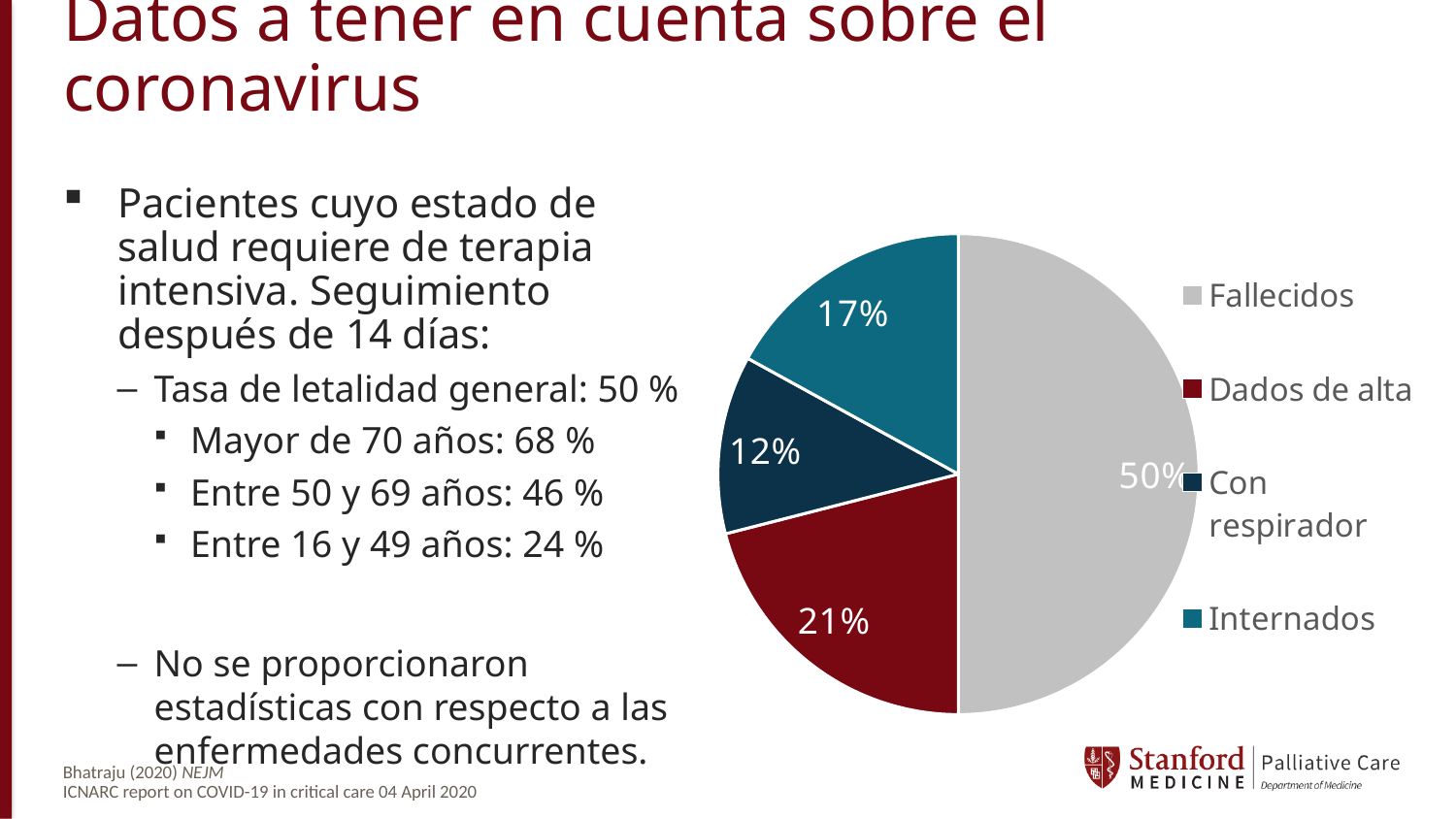
How many categories does the pie chart legend list? 4 Which category has the smallest slice of the pie chart? Con respirador What colour is the Fallecidos slice in the pie chart? grey What percentage of the pie chart is labelled Con respirador? 12% Which slice is larger, Internados or Con respirador? Internados What is the difference in percentage points between the Dados de alta slice and the Internados slice? 4 What is the combined percentage of the Con respirador and Internados slices? 29% What percentage of the pie chart is labelled Internados? 17% Which category has the largest slice of the pie chart? Fallecidos What kind of chart is shown on the slide? pie chart What percentage of the pie chart is labelled Fallecidos? 50% What percentage of the pie chart is labelled Dados de alta? 21%